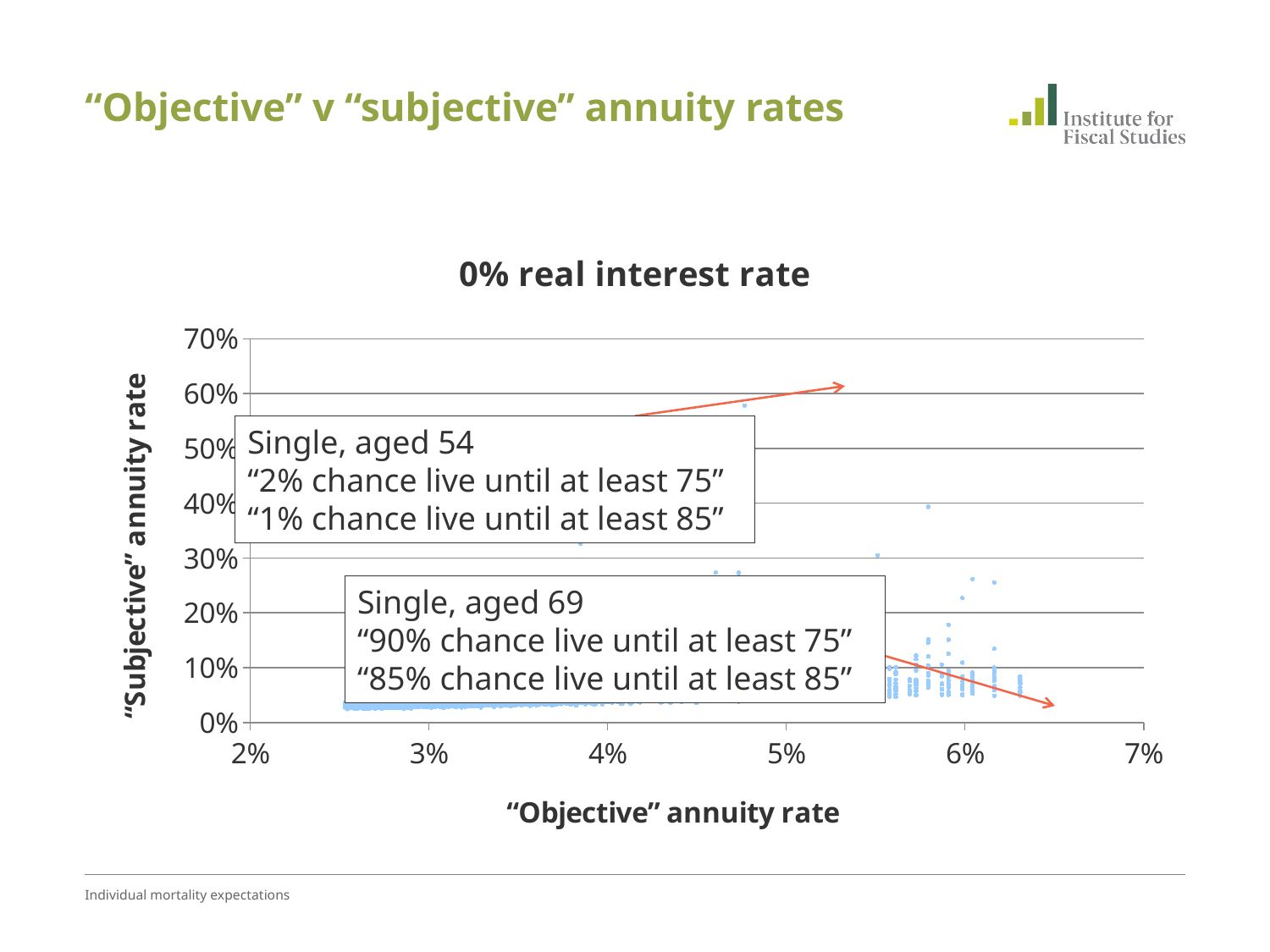
What is the title of the chart? 0% real interest rate What is the label of the horizontal axis of the chart? "Objective" annuity rate What kind of chart is shown on the slide? Scatter chart Is the "objective" annuity rate of the highest plotted point greater or less than 4%? greater What is the range of the horizontal axis of the chart? 2% to 7% Is the "subjective" annuity rate for the dense band of points near a 3% "objective" annuity rate greater or less than 10%? less Is the highest "subjective" annuity rate plotted on the chart greater or less than 50%? greater What is the maximum value shown on the vertical axis of the chart? 70%